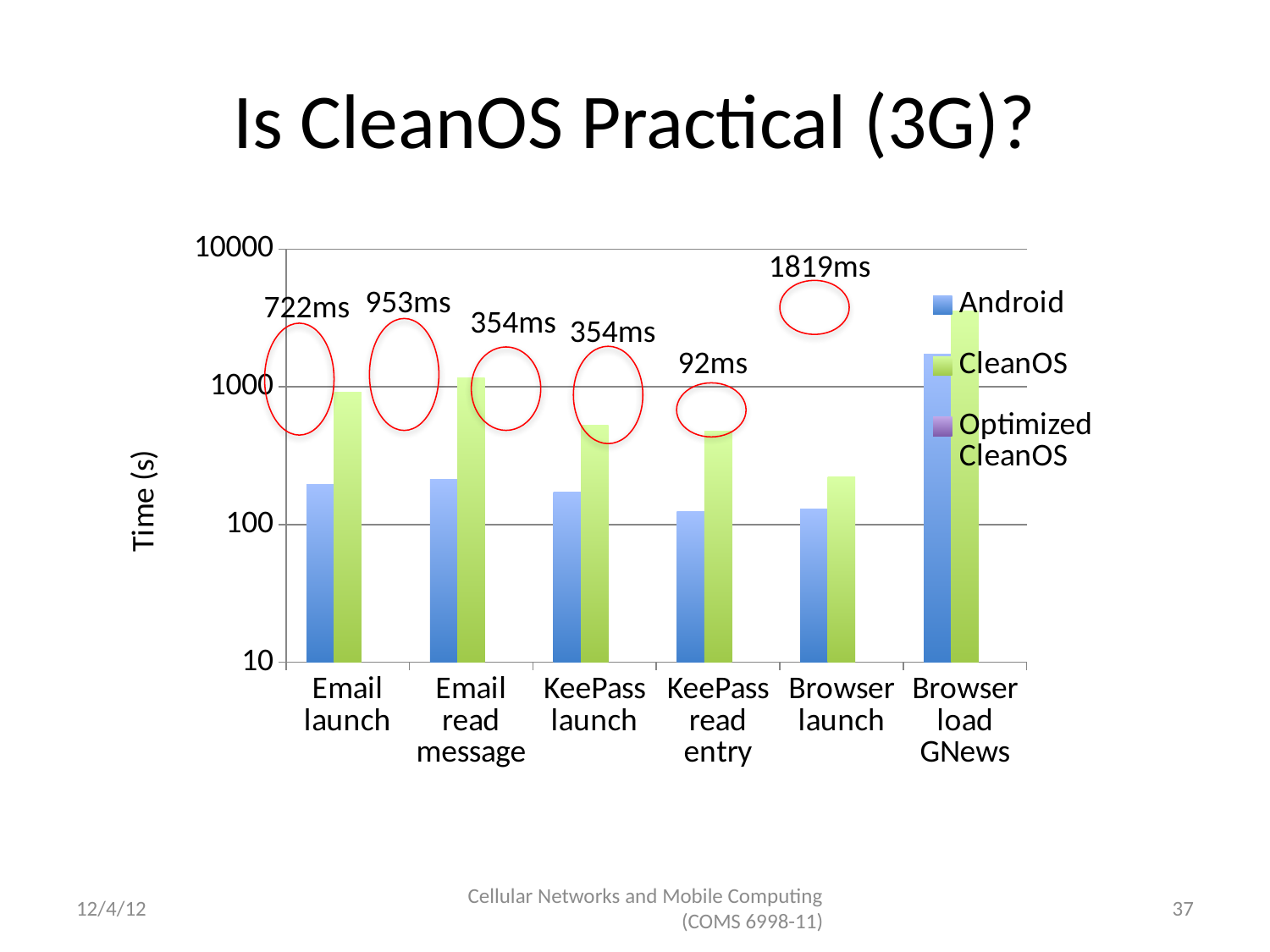
How many categories are shown on the x axis? 6 Which category has the lowest CleanOS value? Browser launch For Email launch, which is larger, the Android value or the CleanOS value? CleanOS Which category has the highest Android value? Browser load GNews What is the label on the y axis? Time (s) How many series does the legend list? 3 What kind of chart is shown on the slide? bar chart Is the CleanOS value for Browser load GNews greater or less than 1000? greater Which category has the highest CleanOS value? Browser load GNews What annotation is printed above the Browser load GNews bars? 1819ms Is the Android value for Email launch greater or less than 100? greater